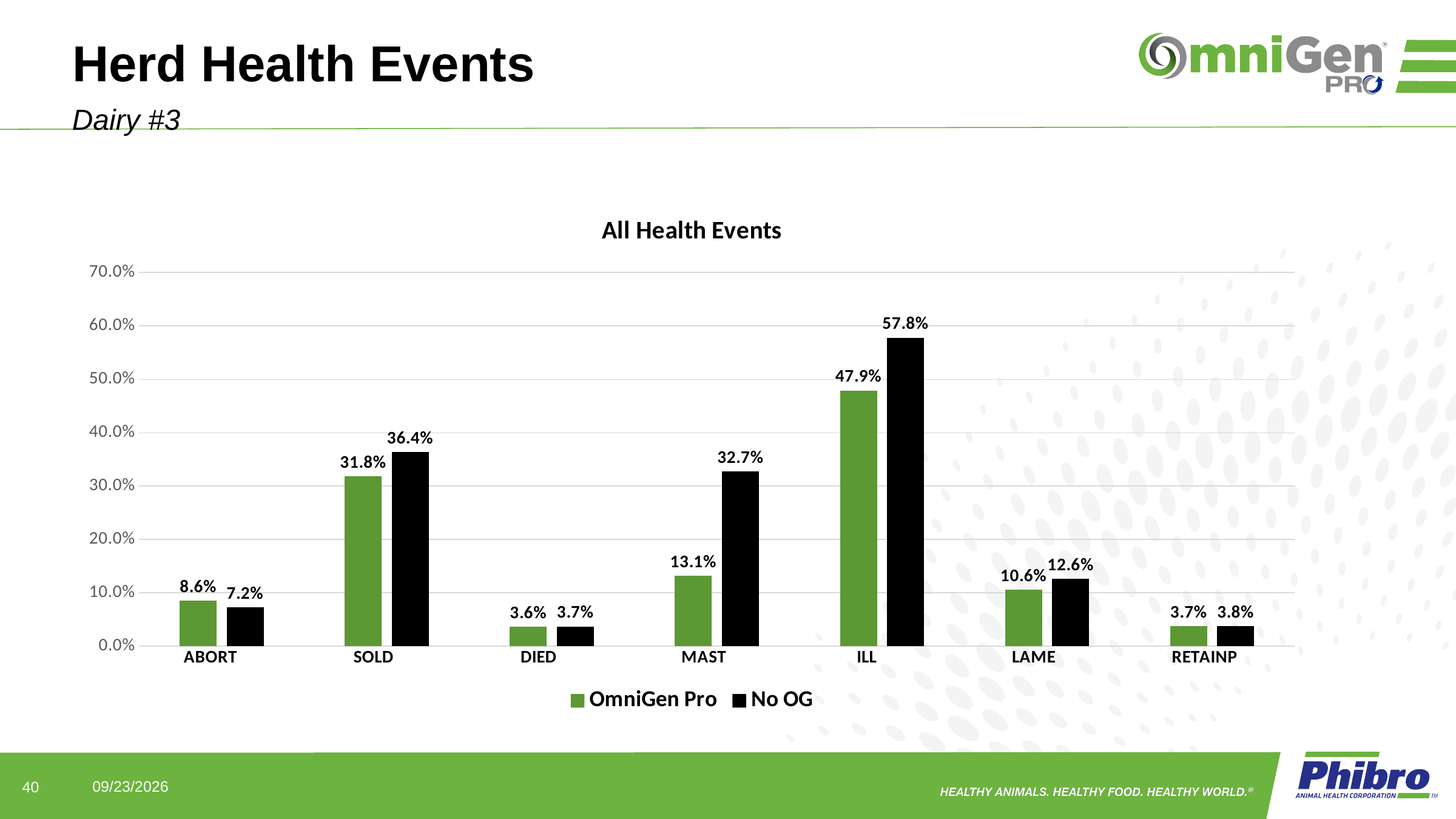
What is the OmniGen Pro value for MAST? 13.1% Is the OmniGen Pro value for ILL greater or less than 50.0%? less How many series does the legend list? 2 For ABORT, which series has the larger value, OmniGen Pro or No OG? OmniGen Pro How many categories are shown on the x axis? 7 What type of chart is shown on the slide? bar chart Which category has the lowest OmniGen Pro value? DIED What is the OmniGen Pro value for ABORT? 8.6% What is the No OG value for ILL? 57.8% What is the difference between the No OG and OmniGen Pro values for MAST? 19.6% Which category has the highest No OG value? ILL What is the difference between the No OG and OmniGen Pro values for SOLD? 4.6%